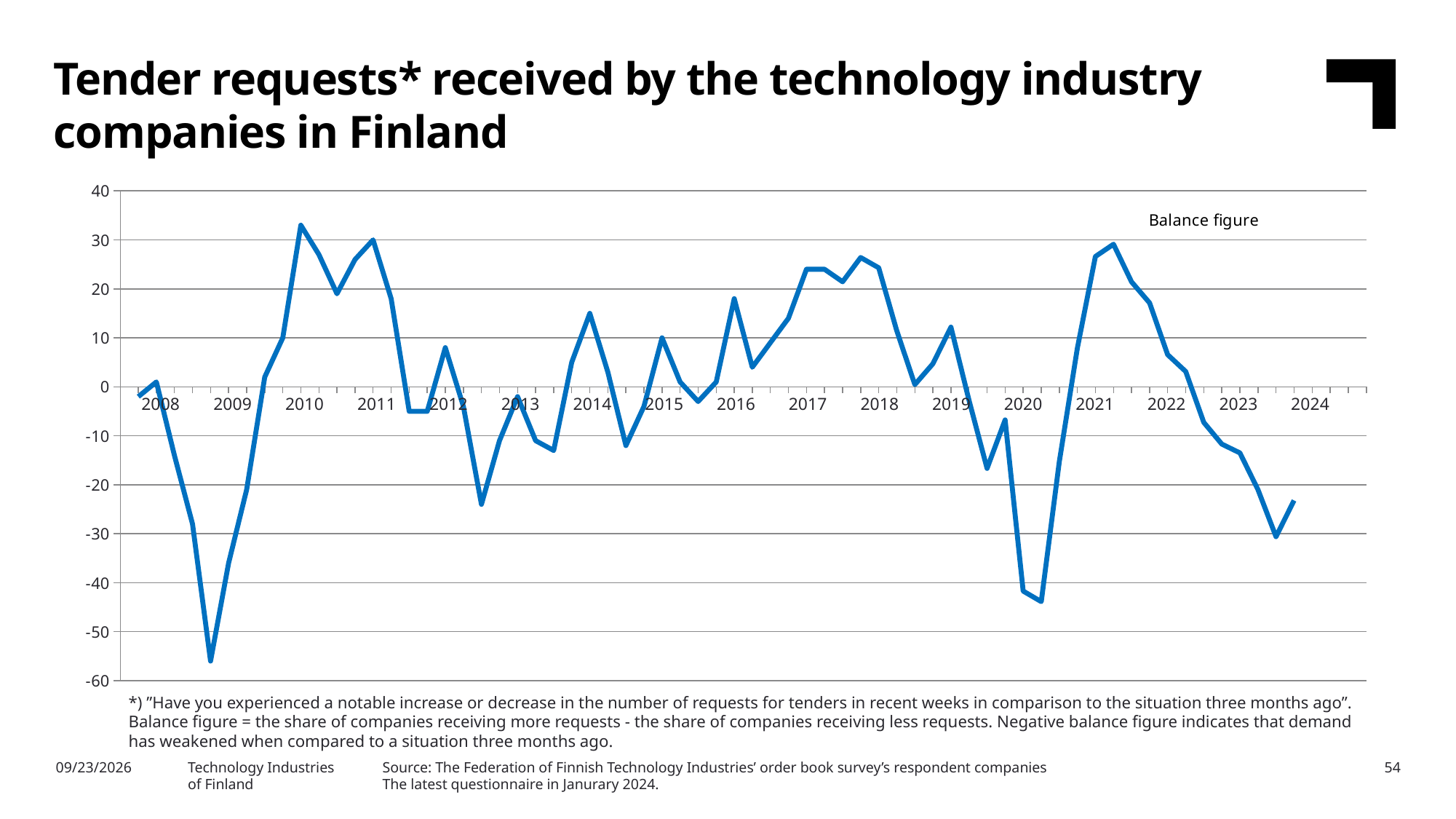
What kind of chart is shown on the slide? line chart Does the balance figure rise or fall between its peak in 2021 and 2023? fall What label is shown in the upper right of the plot area describing the plotted series? Balance figure What is the title of the slide's chart? Tender requests* received by the technology industry companies in Finland Is the lowest value of the line, reached around 2009, greater or less than -50? less Is the trough of the line around 2020 greater or less than -40? less How many year labels are shown on the x axis? 17 Is the peak value of the line around 2010 greater or less than 30? greater Does the balance figure rise or fall between its low point in 2009 and 2010? rise